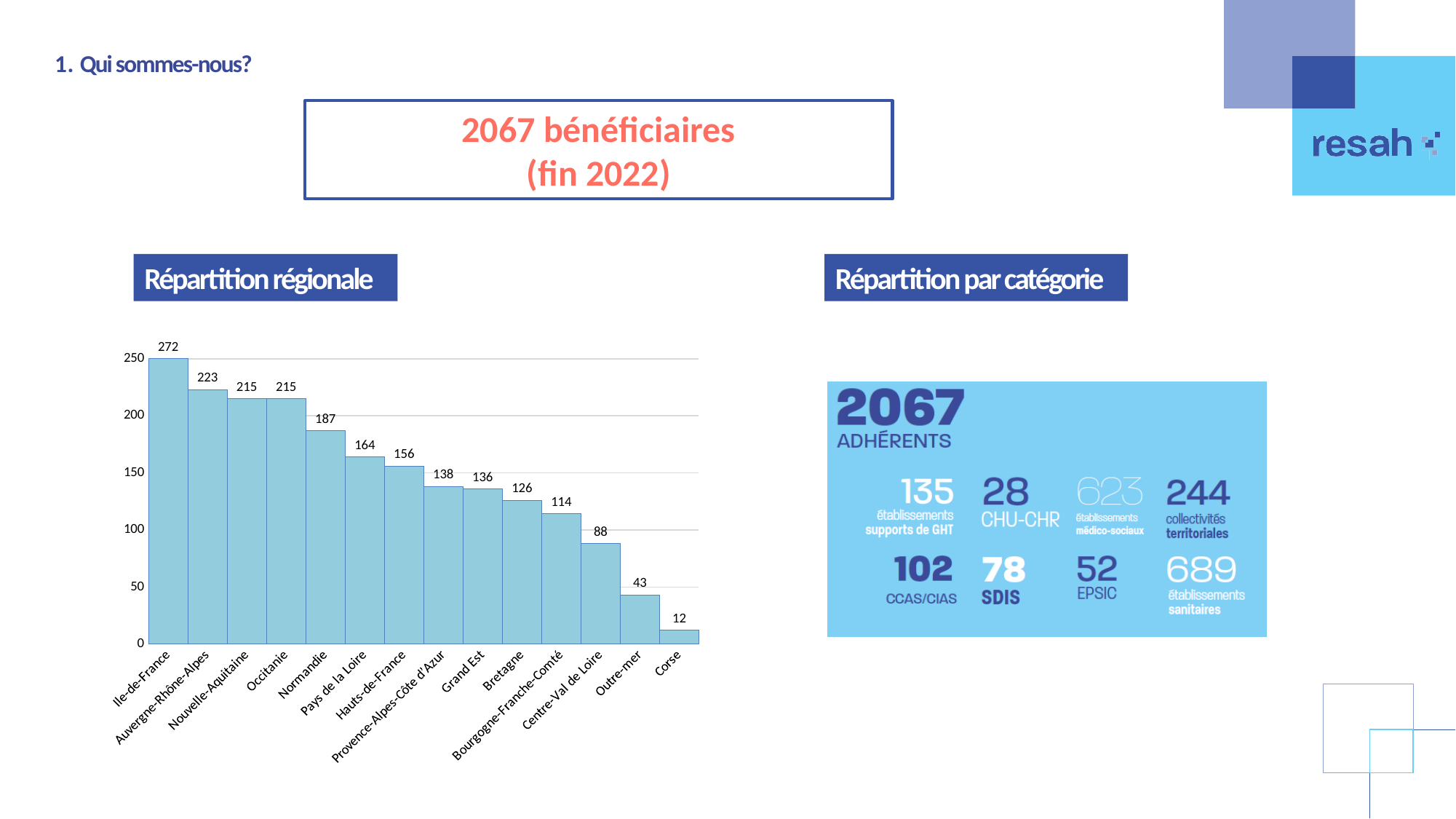
In the 'Répartition régionale' chart, which is larger: Pays de la Loire or Hauts-de-France? Pays de la Loire How many regions are shown in the 'Répartition régionale' chart? 14 In the 'Répartition régionale' chart, what is the value for Bretagne? 126 In the 'Répartition régionale' chart, what is the value for Normandie? 187 In the 'Répartition régionale' chart, which region has the highest value? Ile-de-France In the 'Répartition régionale' chart, what is the difference between Centre-Val de Loire and Corse? 76 In the 'Répartition régionale' chart, is the value for Bourgogne-Franche-Comté greater or less than 100? greater In the 'Répartition régionale' chart, which region has the lowest value? Corse What type of chart is the 'Répartition régionale' chart? bar chart In the 'Répartition régionale' chart, what is the value for Outre-mer? 43 In the 'Répartition régionale' chart, do the values rise or fall from left to right along the x axis? fall In the 'Répartition régionale' chart, what is the difference between Ile-de-France and Auvergne-Rhône-Alpes? 49